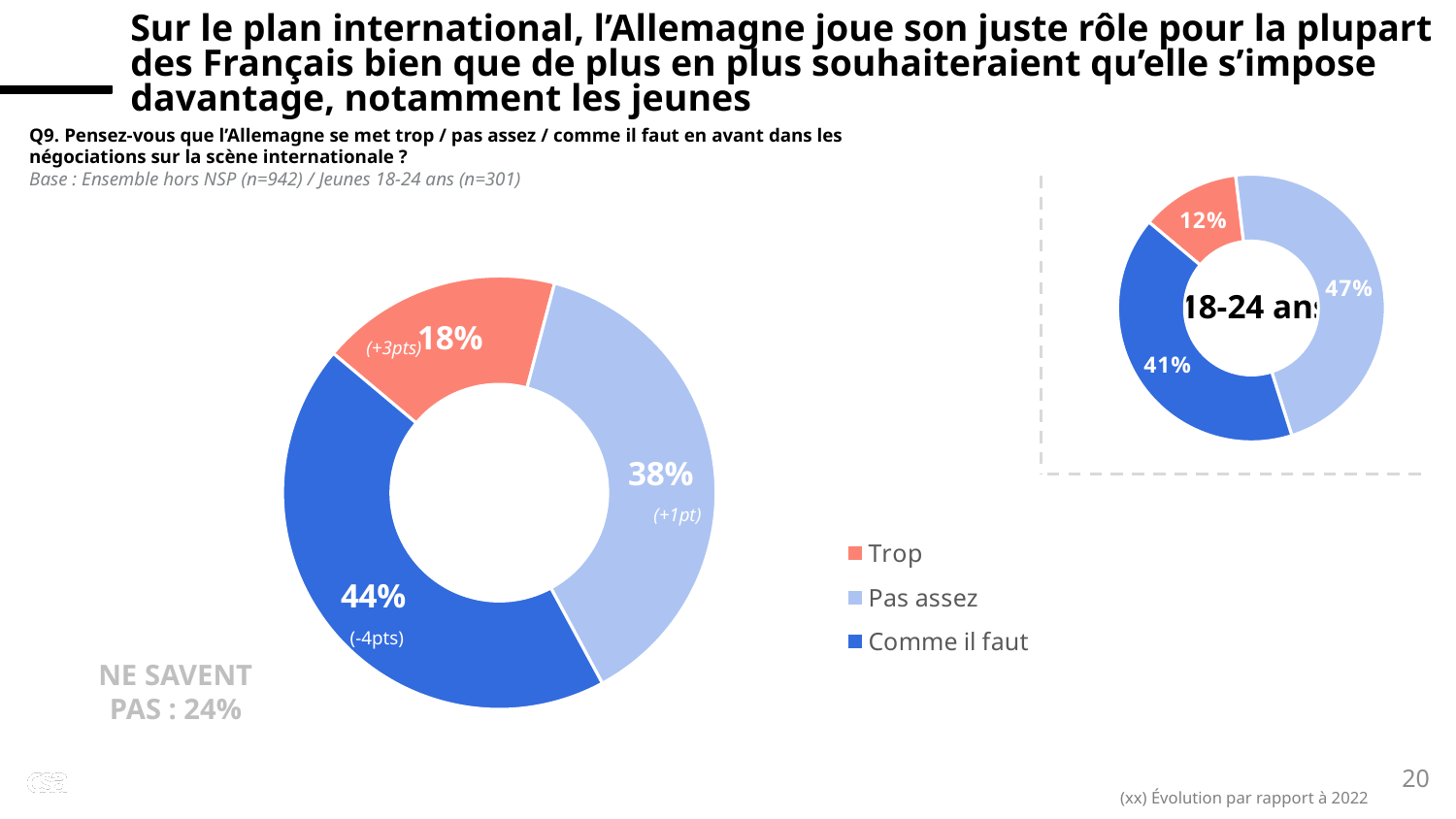
In the large donut chart on the left, what change versus 2022 is indicated next to the "Comme il faut" value? -4pts How many entries does the legend list? 3 In the small "18-24 ans" donut chart, which is larger: "Pas assez" or "Comme il faut"? Pas assez In the large donut chart on the left, which category has the largest share? Comme il faut In the large donut chart on the left, what percentage is shown for "Pas assez"? 38% What kind of chart is used on this slide? Donut (pie) chart In the large donut chart on the left, what percentage is shown for "Trop"? 18% In the small "18-24 ans" donut chart, what percentage is shown for "Pas assez"? 47% In the large donut chart on the left, what percentage is shown for "Comme il faut"? 44% In the small "18-24 ans" donut chart, what percentage is shown for "Trop"? 12% In the small "18-24 ans" donut chart, which category has the smallest share? Trop In the large donut chart on the left, what is the difference in percentage points between "Comme il faut" and "Pas assez"? 6 points